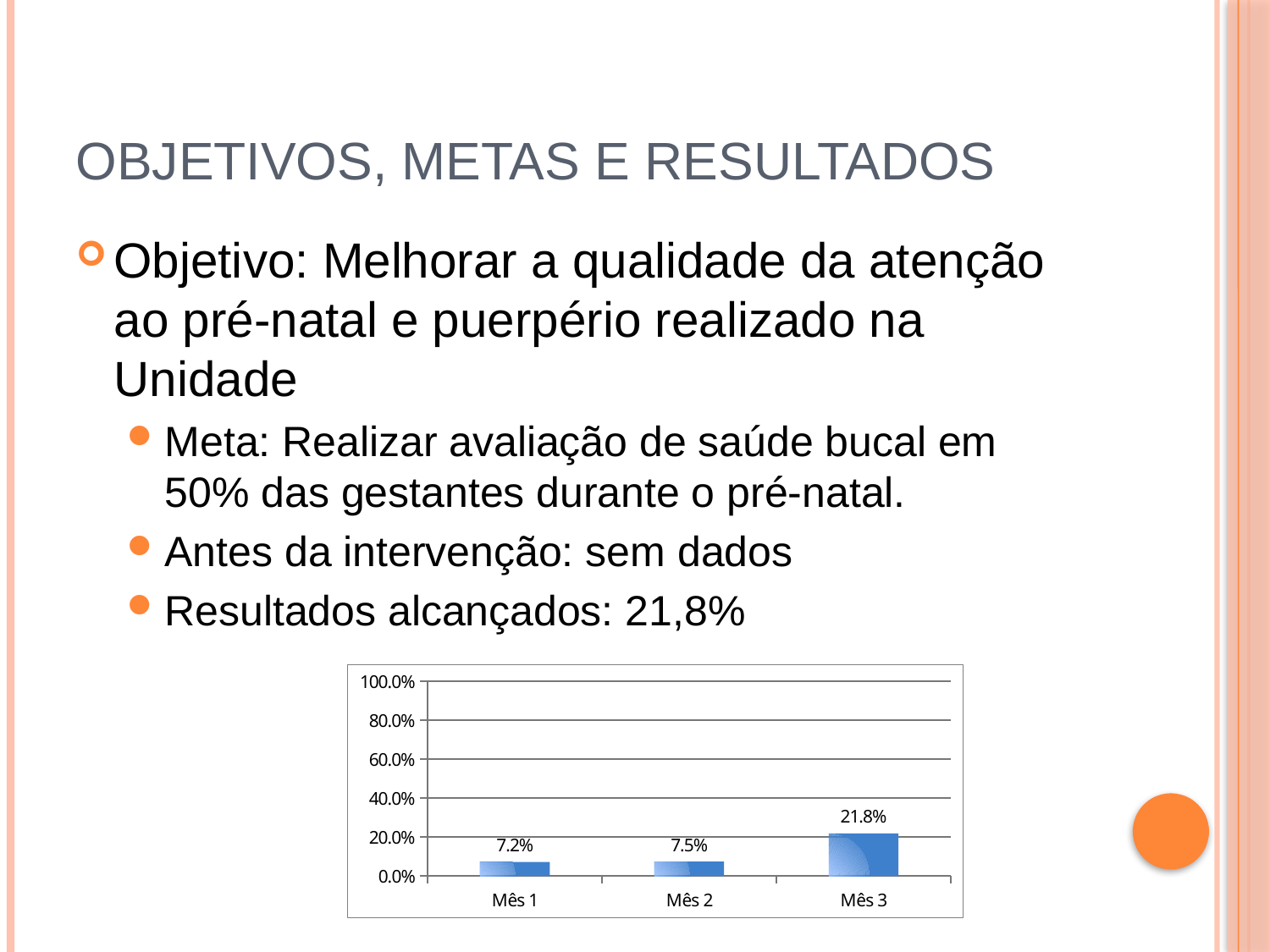
What is the value for Mês 1? 7.2% Do the values rise or fall from Mês 1 to Mês 3? rise Is the value for Mês 3 greater or less than 40.0%? less What kind of chart is shown on the slide? bar chart What is the value for Mês 2? 7.5% What is the difference between the values for Mês 2 and Mês 1? 0.3% What is the value for Mês 3? 21.8% Which month has the highest value? Mês 3 Which month has the lowest value? Mês 1 Which is larger, the value for Mês 3 or the value for Mês 2? Mês 3 How many months are shown on the x axis? 3 What is the difference between the values for Mês 3 and Mês 1? 14.6%